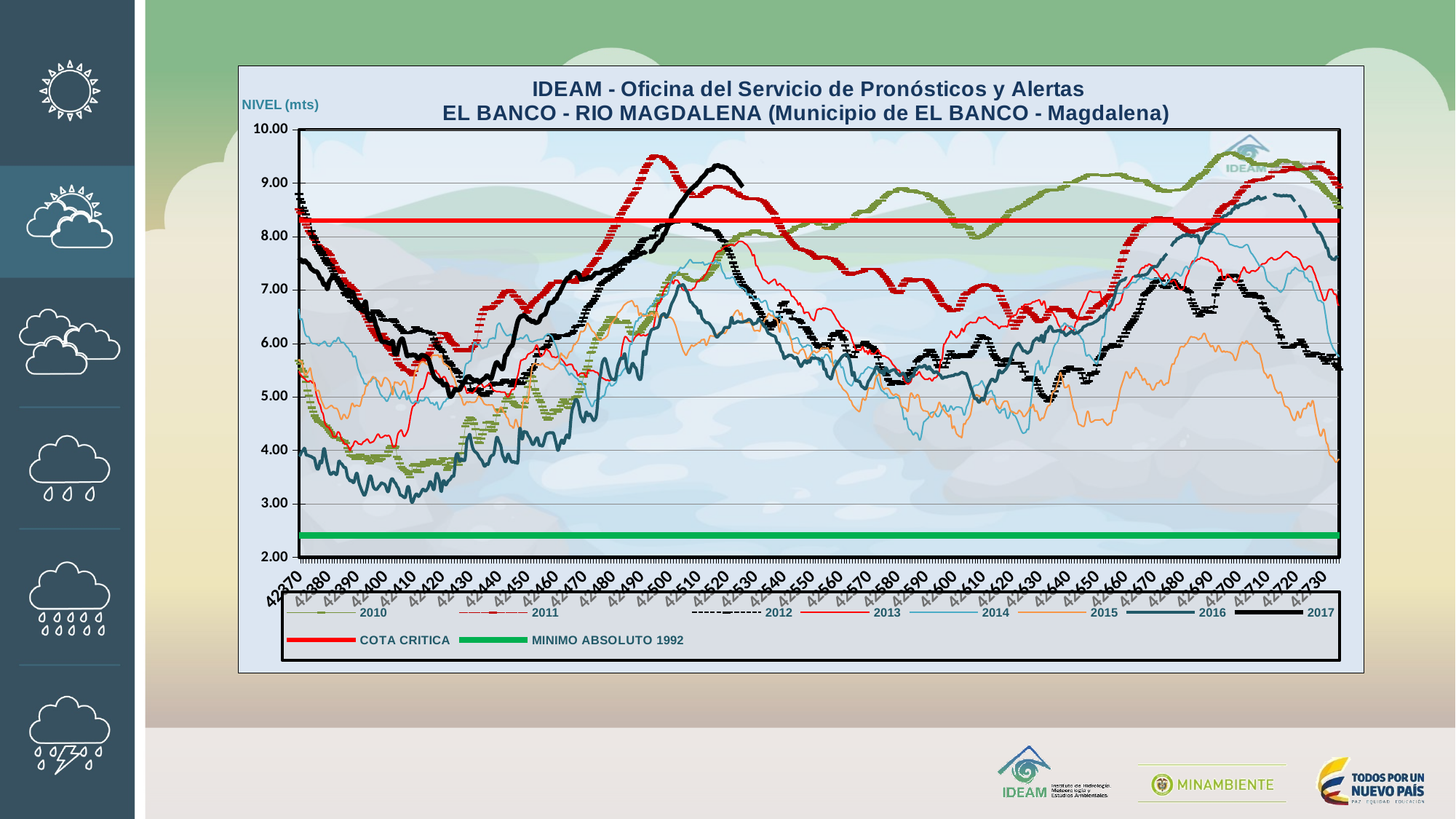
What is the label on the vertical axis of the chart? NIVEL (mts) Which series reaches the lowest level anywhere on the chart? 2016 Is the value of the 2015 series at 42730 greater or less than 5.00? less At 42370, which series is higher, 2011 or 2016? 2011 Is the MINIMO ABSOLUTO 1992 line greater or less than 3.00? less Is the value of the 2016 series at 42370 greater or less than 5.00? less How many series does the legend list? 10 What colour is the COTA CRITICA line in the chart? red What is the highest value shown on the vertical axis? 10.00 What kind of chart is shown on the slide? line chart